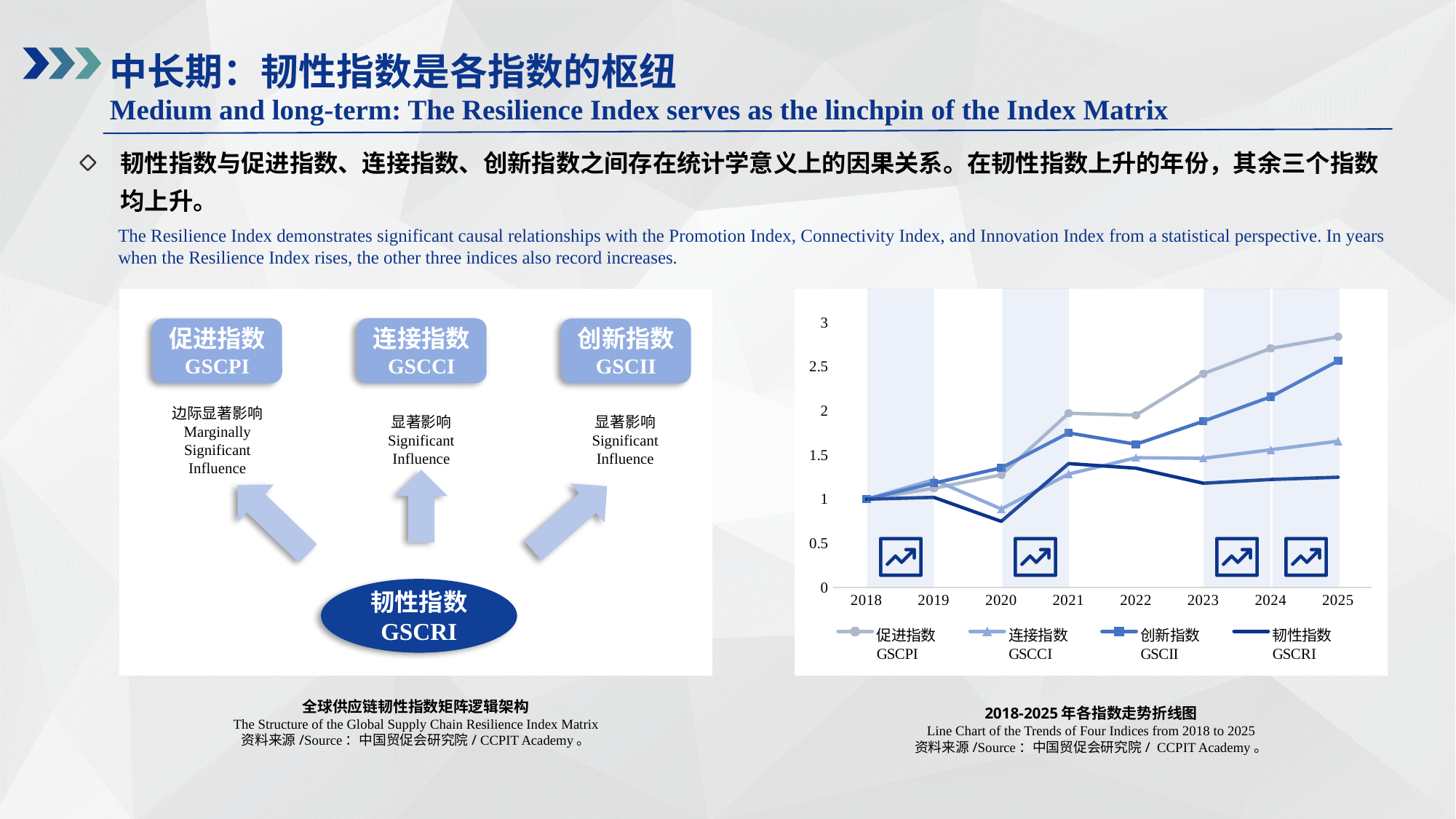
In the line chart, is the value of 韧性指数 GSCRI in 2025 greater or less than 1.5? less In the line chart, which index has the lowest value in 2025? 韧性指数 GSCRI How many years are shown on the x axis of the line chart? 8 In the line chart, does 促进指数 GSCPI rise or fall overall from 2018 to 2025? rise How many series does the legend of the line chart list? 4 In the line chart, is the value of 韧性指数 GSCRI in 2020 greater or less than 1? less In the line chart, which index has the highest value in 2025? 促进指数 GSCPI What is the first year shown on the x axis of the line chart? 2018 In the line chart, is the value of 促进指数 GSCPI in 2023 greater or less than 2? greater What kind of chart is the chart titled "2018-2025 年各指数走势折线图"? line chart In the line chart, which is larger in 2025: 促进指数 GSCPI or 连接指数 GSCCI? 促进指数 GSCPI